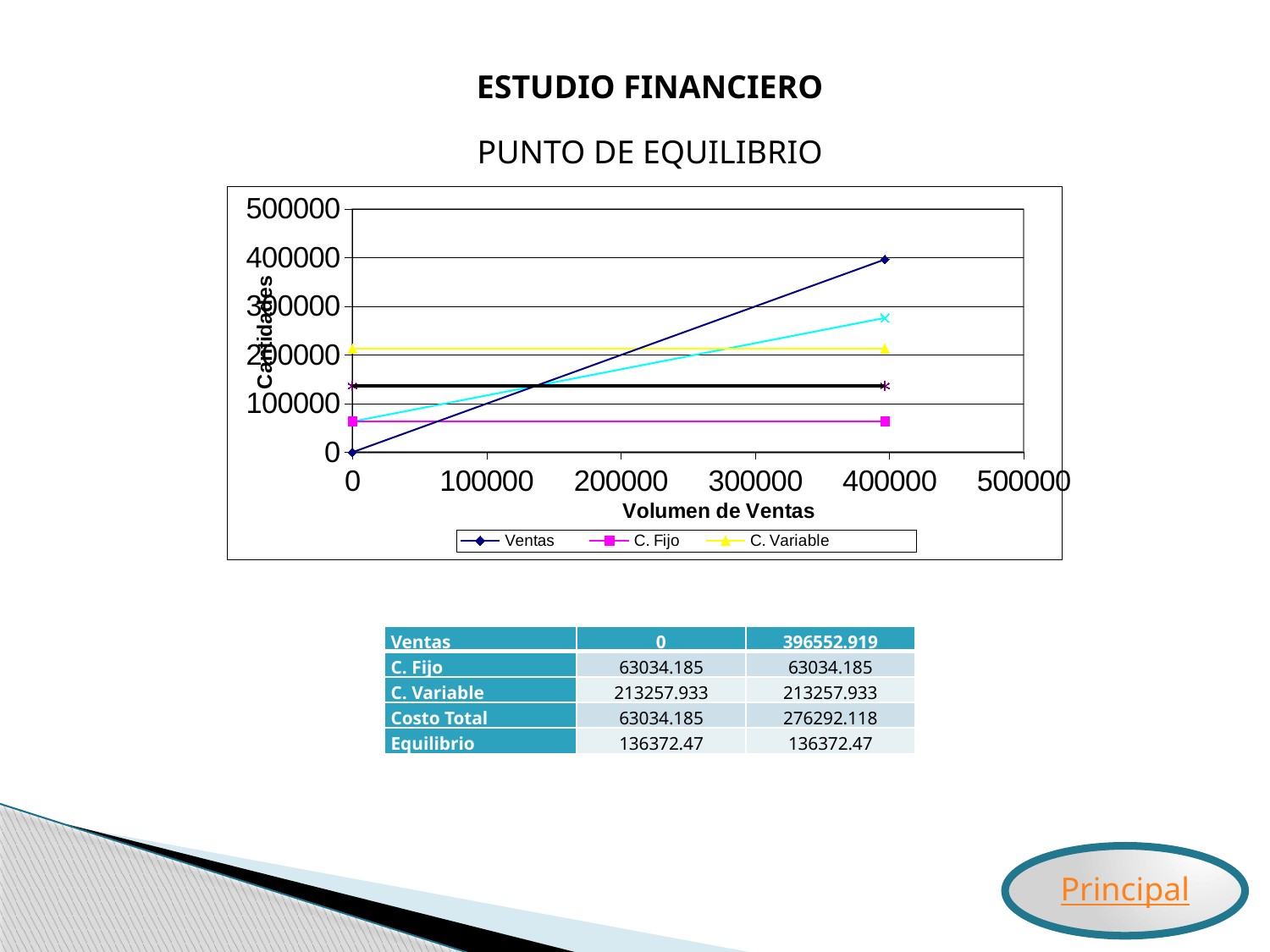
What kind of chart is shown on the slide? line chart What is the title of the x axis of the chart? Volumen de Ventas Does the Ventas line rise or fall as Volumen de Ventas increases? rise What is the Ventas value at the second data point, as given in the table below the chart? 396552.919 At the right end of the chart, which is higher: the Ventas line or the C. Variable line? Ventas Is the value of the C. Variable line greater or less than 300000? less How many series does the chart legend list? 3 Is the value of the C. Fijo line greater or less than 100000? less What is the value of C. Fijo according to the table below the chart? 63034.185 Which series reaches the highest value at the right end of the chart? Ventas What is the title of the y axis of the chart? Cantidades By how much does Costo Total increase between the first and second columns of the table? 213257.933